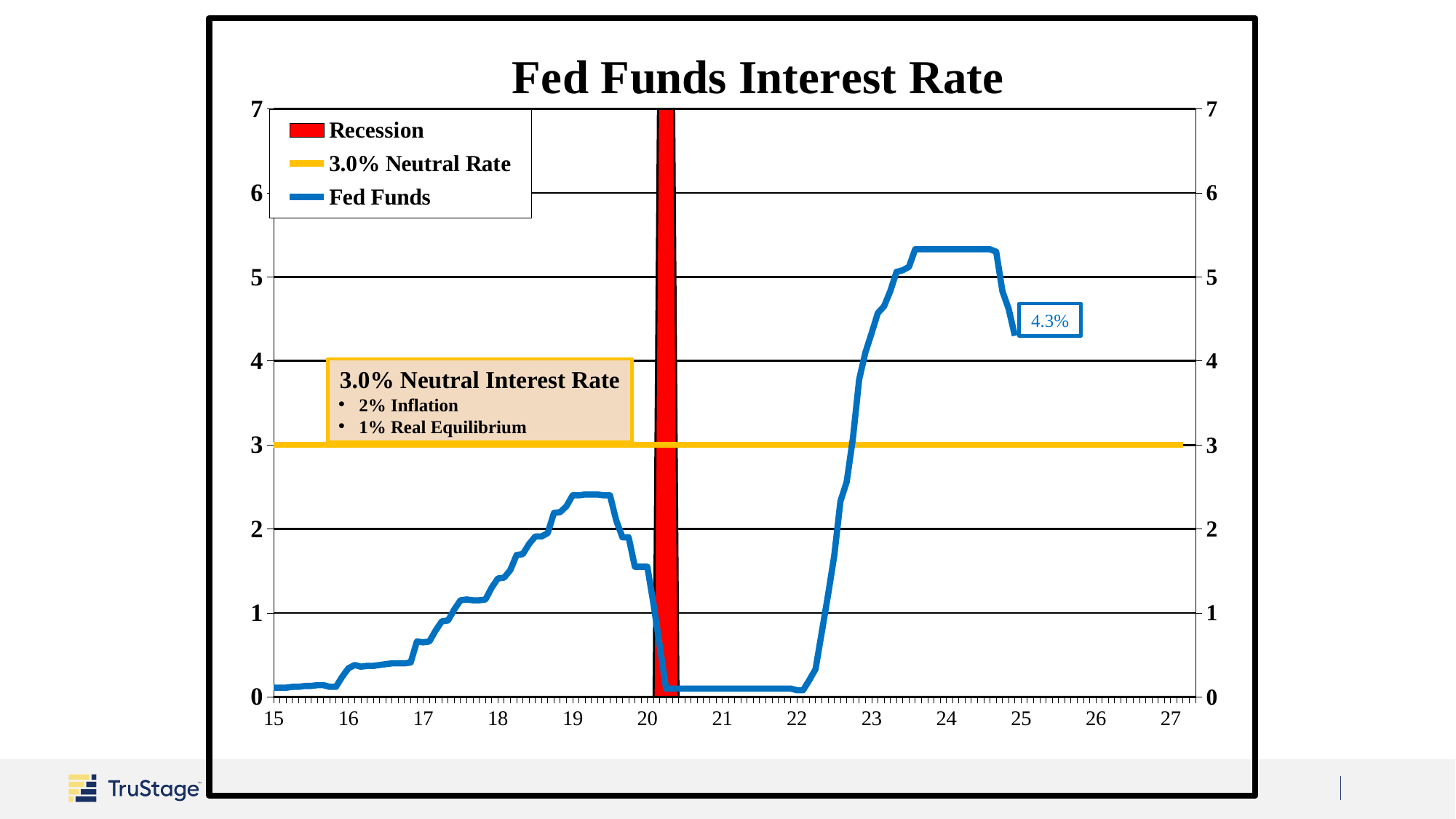
What kind of chart is shown on the slide? line chart How many entries does the chart's legend list? 3 What colour is used for the Recession marker in the legend? red Is the Fed Funds value in 2021 greater or less than 1? less What value is printed in the data label at the end of the Fed Funds line? 4.3% What is the title of the chart? Fed Funds Interest Rate Is the Fed Funds value in 2017 greater or less than 2? less Does the Fed Funds line rise or fall between 2022 and 2023? rise Is the Fed Funds peak around 2019 greater or less than 3? less What is the value of the neutral rate line shown on the chart? 3.0% Which is larger, the Fed Funds value in 2024 or in 2019? 2024